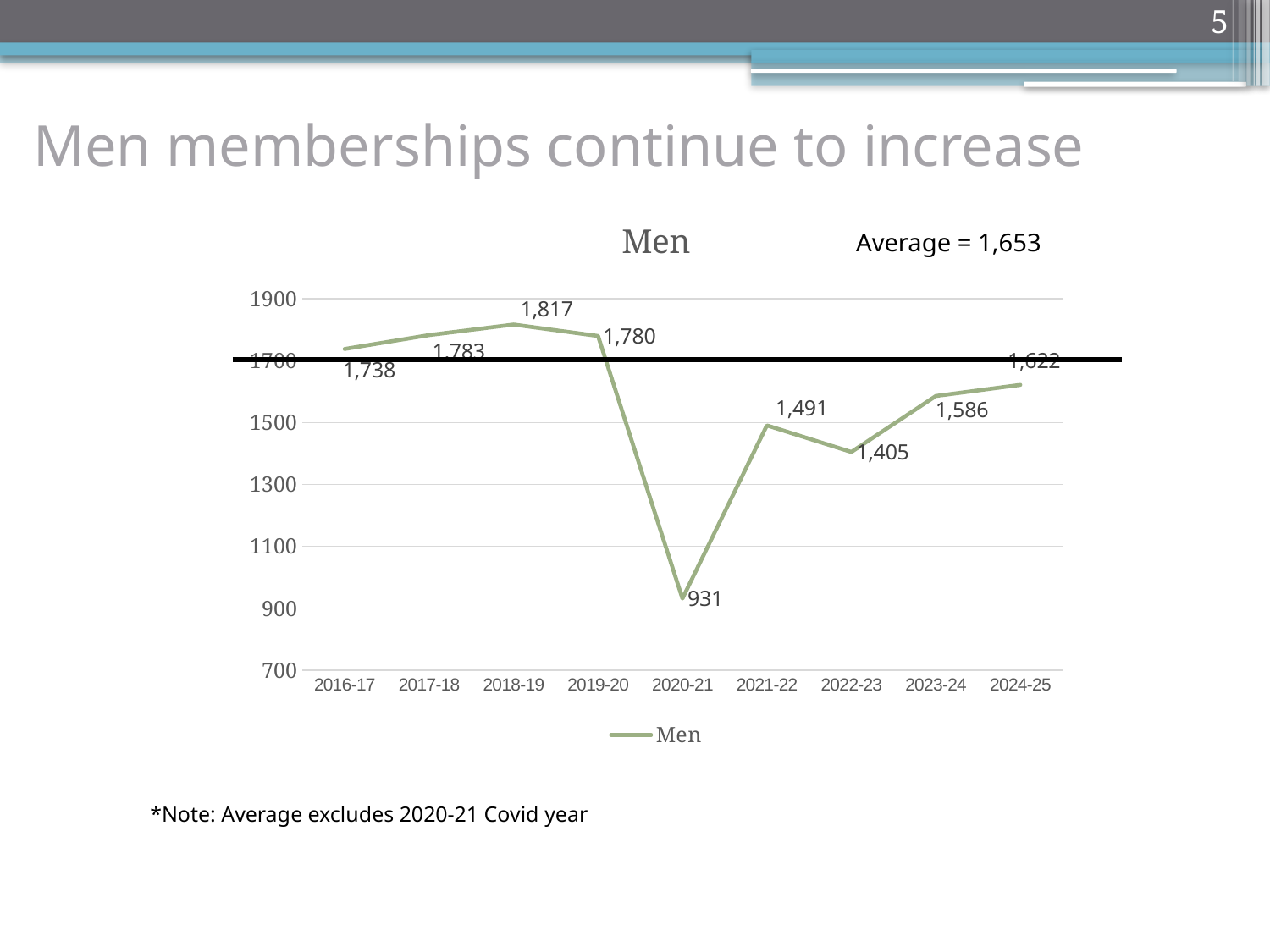
How many years are plotted on the x axis? 9 How many series does the legend list? 1 Which is larger, the Men value for 2021-22 or for 2022-23? 2021-22 What is the value for Men in 2024-25? 1,622 What type of chart is shown on the slide? line chart Which year has the lowest Men membership value? 2020-21 Which year has the highest Men membership value? 2018-19 What is the difference between the Men values for 2024-25 and 2023-24? 36 What average value is stated on the chart? 1,653 What is the value for Men in 2020-21? 931 Do the Men values rise or fall from 2022-23 to 2024-25? rise What is the value for Men in 2018-19? 1,817